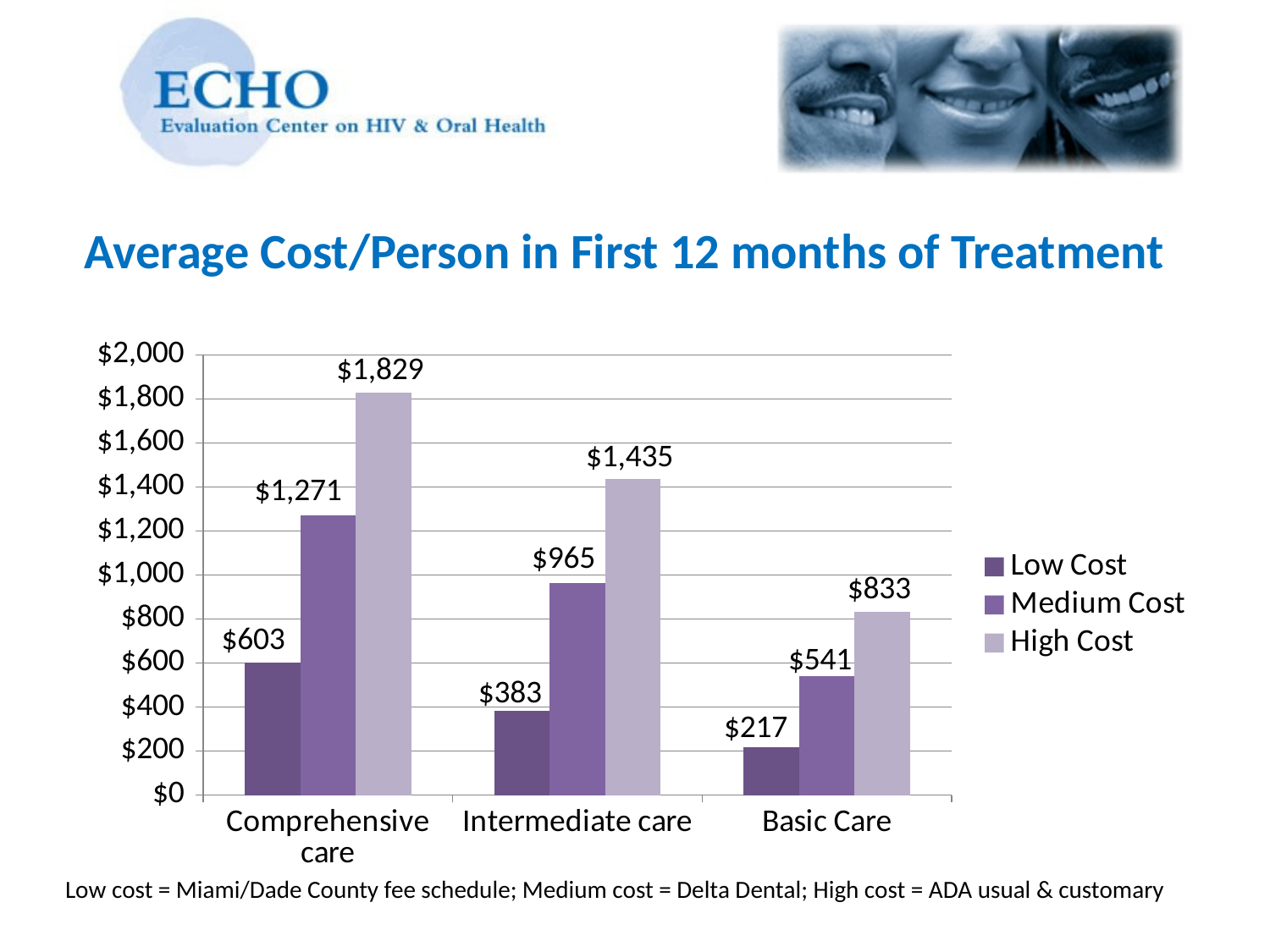
Do the Medium Cost values rise or fall from Comprehensive care to Basic Care? Fall How many care categories are shown on the x axis? 3 Which care category has the lowest Low Cost value? Basic Care What is the High Cost value for Comprehensive care? $1,829 How many series does the legend list? 3 What is the difference between the High Cost and Low Cost values for Intermediate care? $1,052 Which care category has the highest High Cost value? Comprehensive care What is the Low Cost value for Basic Care? $217 What kind of chart is shown on the slide? Bar chart Which is larger: the Medium Cost value for Comprehensive care or the High Cost value for Basic Care? Medium Cost value for Comprehensive care What is the Medium Cost value for Intermediate care? $965 What is the title of the chart? Average Cost/Person in First 12 months of Treatment